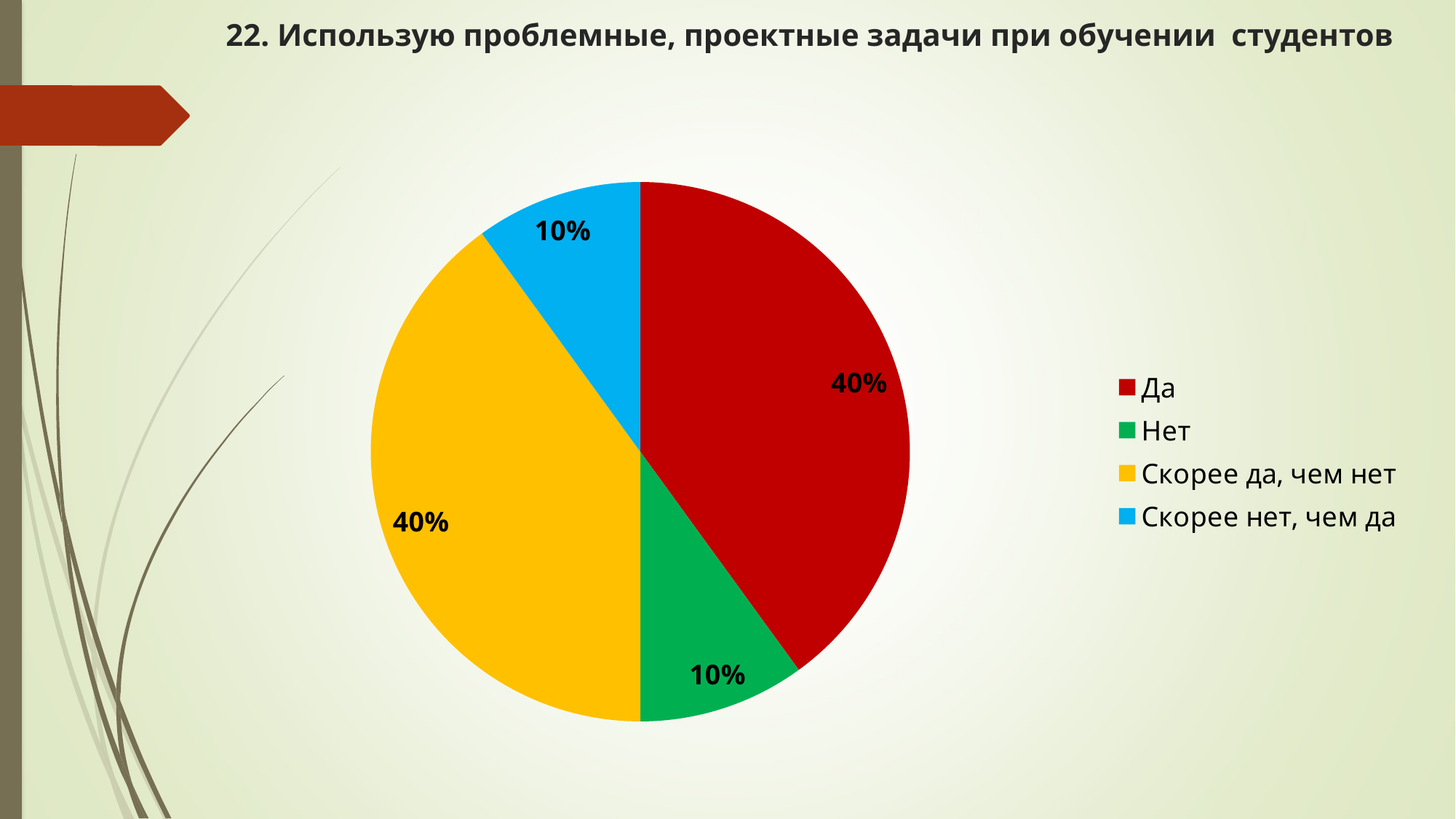
What percentage of the pie does the "Да" slice represent? 40% What type of chart is shown on the slide? pie chart What is the difference in percentage points between "Да" and "Скорее нет, чем да"? 30 What is the value for "Скорее нет, чем да"? 10% What percentage is shown for "Нет"? 10% What is the value for "Скорее да, чем нет"? 40% What colour is the "Скорее да, чем нет" slice? yellow Which is larger, the share for "Да" or the share for "Нет"? Да How many slices does the pie chart have? 4 Which is larger, "Скорее да, чем нет" or "Скорее нет, чем да"? Скорее да, чем нет How many entries does the legend list? 4 What is the title of the chart? 22. Использую проблемные, проектные задачи при обучении студентов